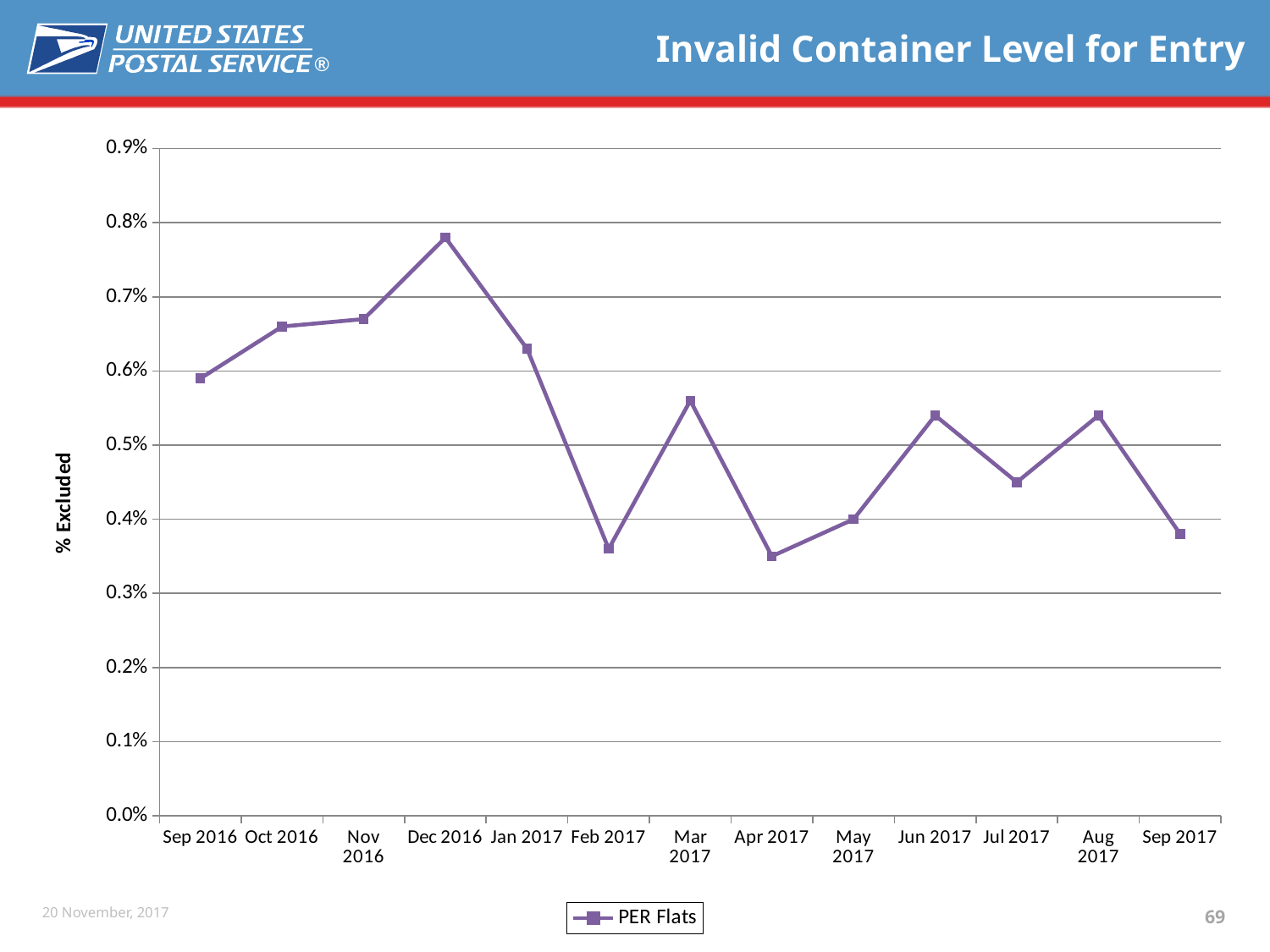
Which is larger, the value for Jun 2017 or the value for Jul 2017? Jun 2017 What is the name of the series shown in the legend? PER Flats Is the value for Feb 2017 greater or less than 0.4%? less Which month has the highest % Excluded value? Dec 2016 Is the value for Dec 2016 greater or less than 0.7%? greater Do the values rise or fall from Sep 2016 to Dec 2016? rise Is the value for Mar 2017 greater or less than 0.5%? greater How many series does the legend list? 1 Which is larger, the value for Dec 2016 or the value for Jan 2017? Dec 2016 How many monthly data points are plotted on the chart? 13 What kind of chart is shown on the slide? line chart